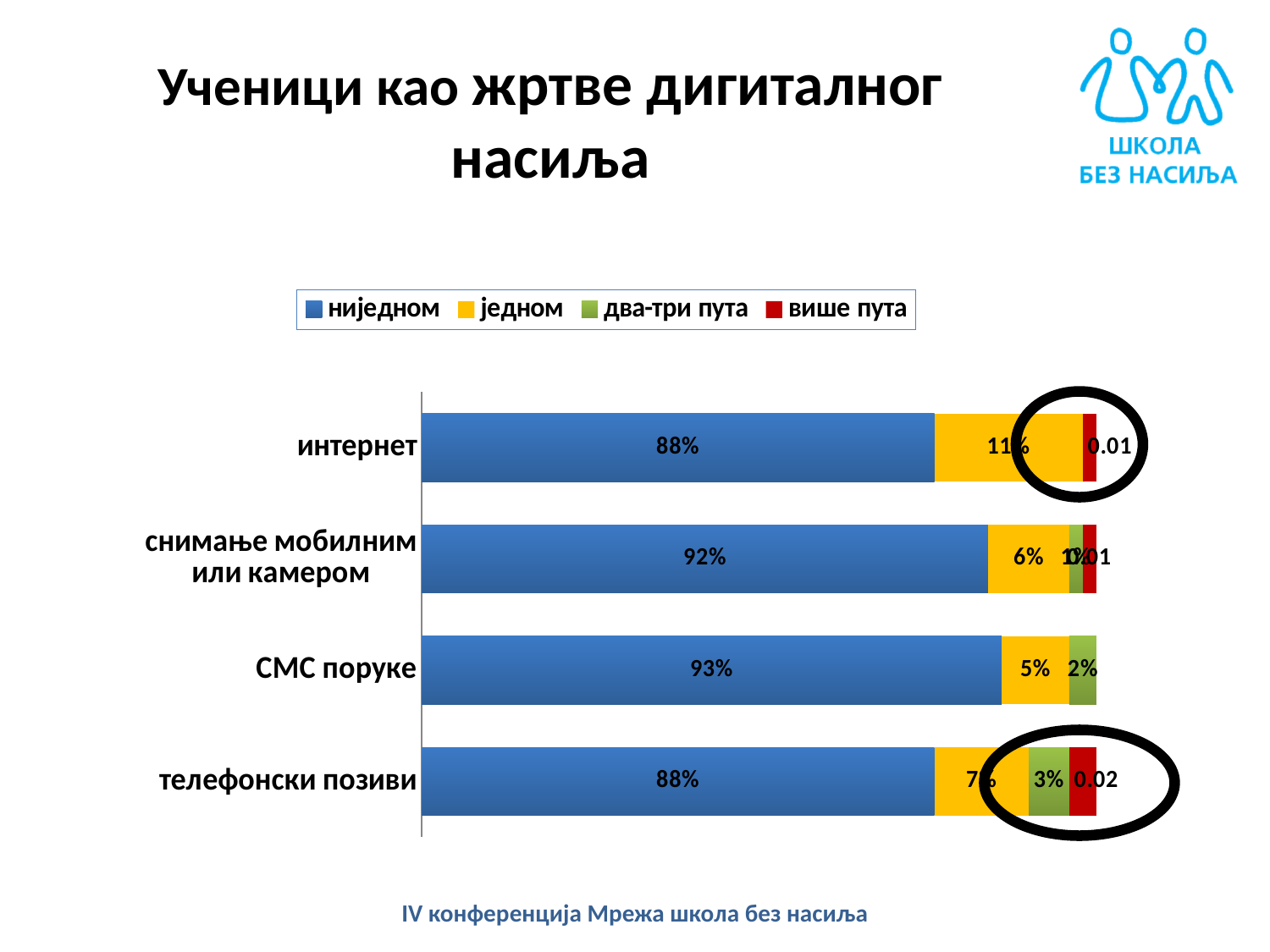
Which category has the highest value for 'ниједном'? СМС поруке What is the value of 'више пута' for 'телефонски позиви'? 0.02 What is the value of 'више пута' for 'интернет'? 0.01 How many categories are plotted on the chart? 4 What is the value of 'два-три пута' for 'СМС поруке'? 2% How many series does the legend list? 4 Which is larger, the 'ниједном' value for 'интернет' or for 'снимање мобилним или камером'? снимање мобилним или камером What kind of chart is shown on the slide? bar chart What is the value of 'два-три пута' for 'телефонски позиви'? 3% What is the difference between the 'ниједном' values for 'СМС поруке' and 'интернет'? 5% What is the value of 'ниједном' for 'снимање мобилним или камером'? 92% What is the value of 'ниједном' for 'СМС поруке'? 93%